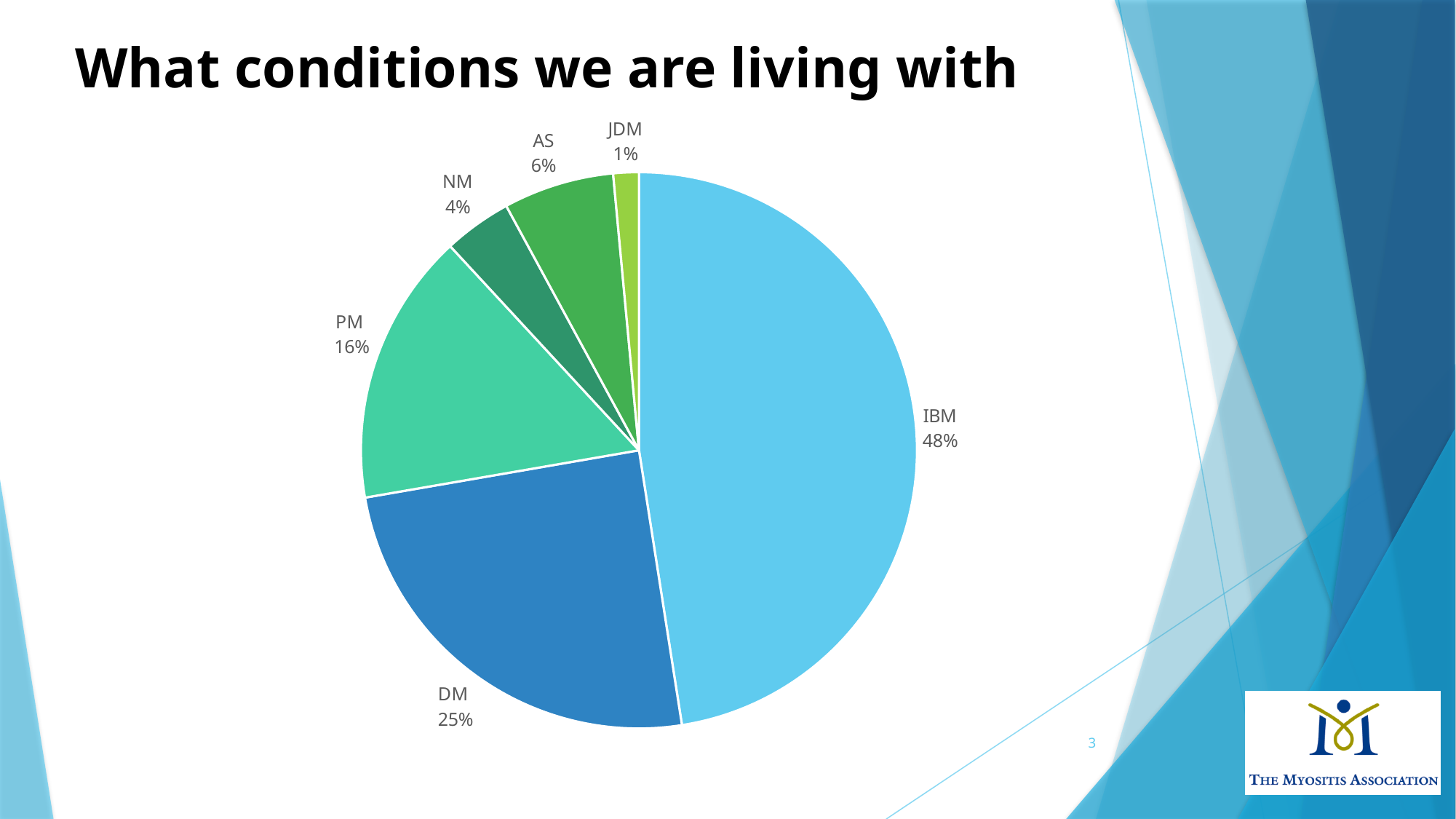
What share of the pie does IBM represent? 48% What is the value shown for AS? 6% What is the value shown for DM? 25% What is the difference in percentage points between IBM and DM? 23 How many slices does the pie chart have? 6 Which condition has the smallest slice of the pie? JDM What is the value shown for NM? 4% What is the title of the chart on the slide? What conditions we are living with What type of chart is shown on the slide? pie chart Which is larger, the share for PM or the share for AS? PM What is the value shown for PM? 16% Which condition has the largest slice of the pie? IBM